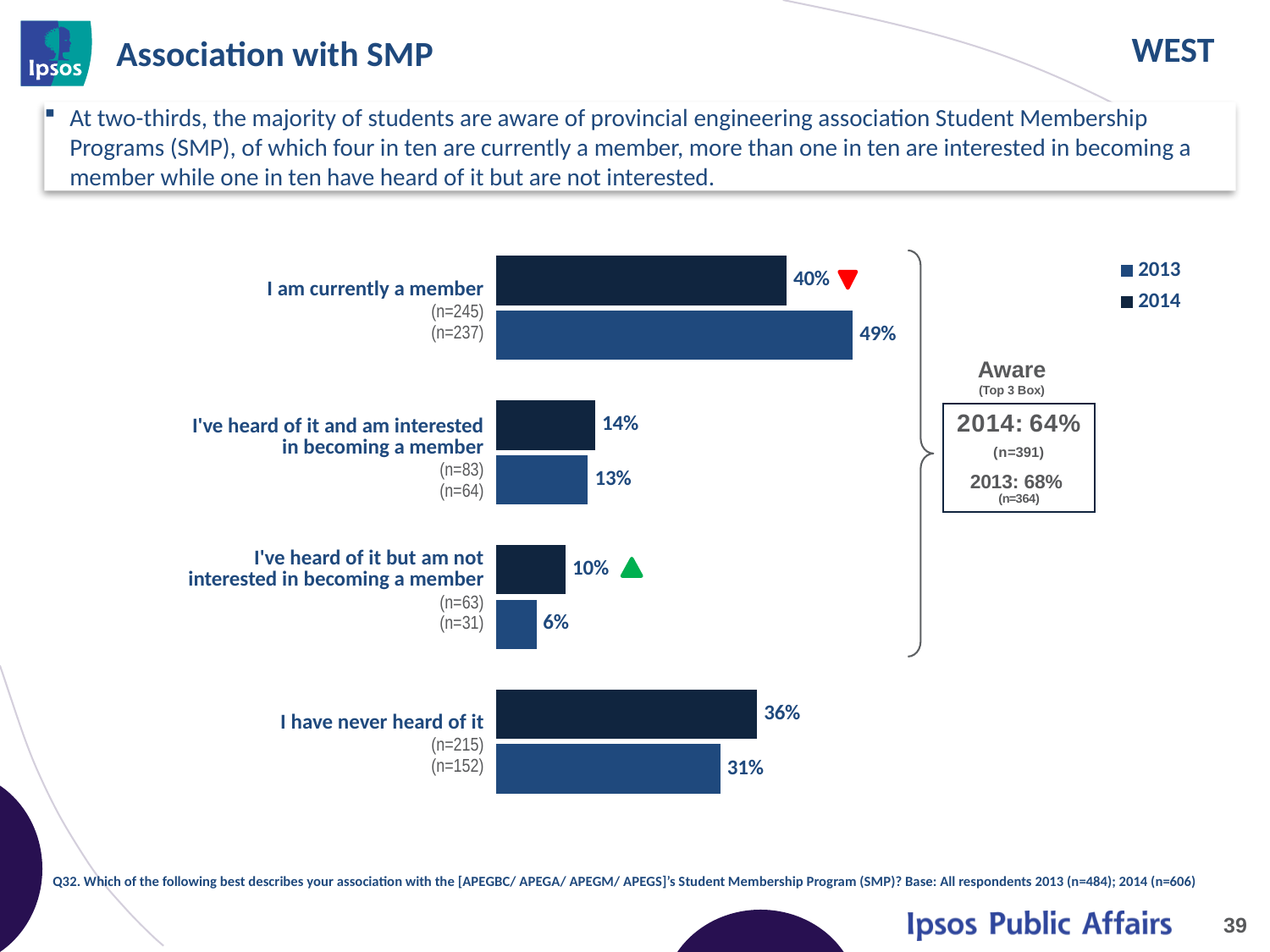
What is the 2014 'Aware (Top 3 Box)' value shown beside the chart? 64% How many response categories are plotted in the chart? 4 Which category has the highest value in the chart? I am currently a member What is the difference between the two bars for 'I am currently a member'? 9 percentage points Which years are listed in the chart legend? 2013 and 2014 What is the value of the lower bar for 'I have never heard of it'? 31% What type of chart is shown on the slide? bar chart How many series does the chart legend list? 2 What is the lowest value shown in the chart? 6% For 'I've heard of it and am interested in becoming a member', which bar is larger, the upper (14%) or the lower (13%)? the upper bar What is the value of the upper bar for 'I am currently a member'? 40% What is the value of the lower bar for 'I am currently a member'? 49%